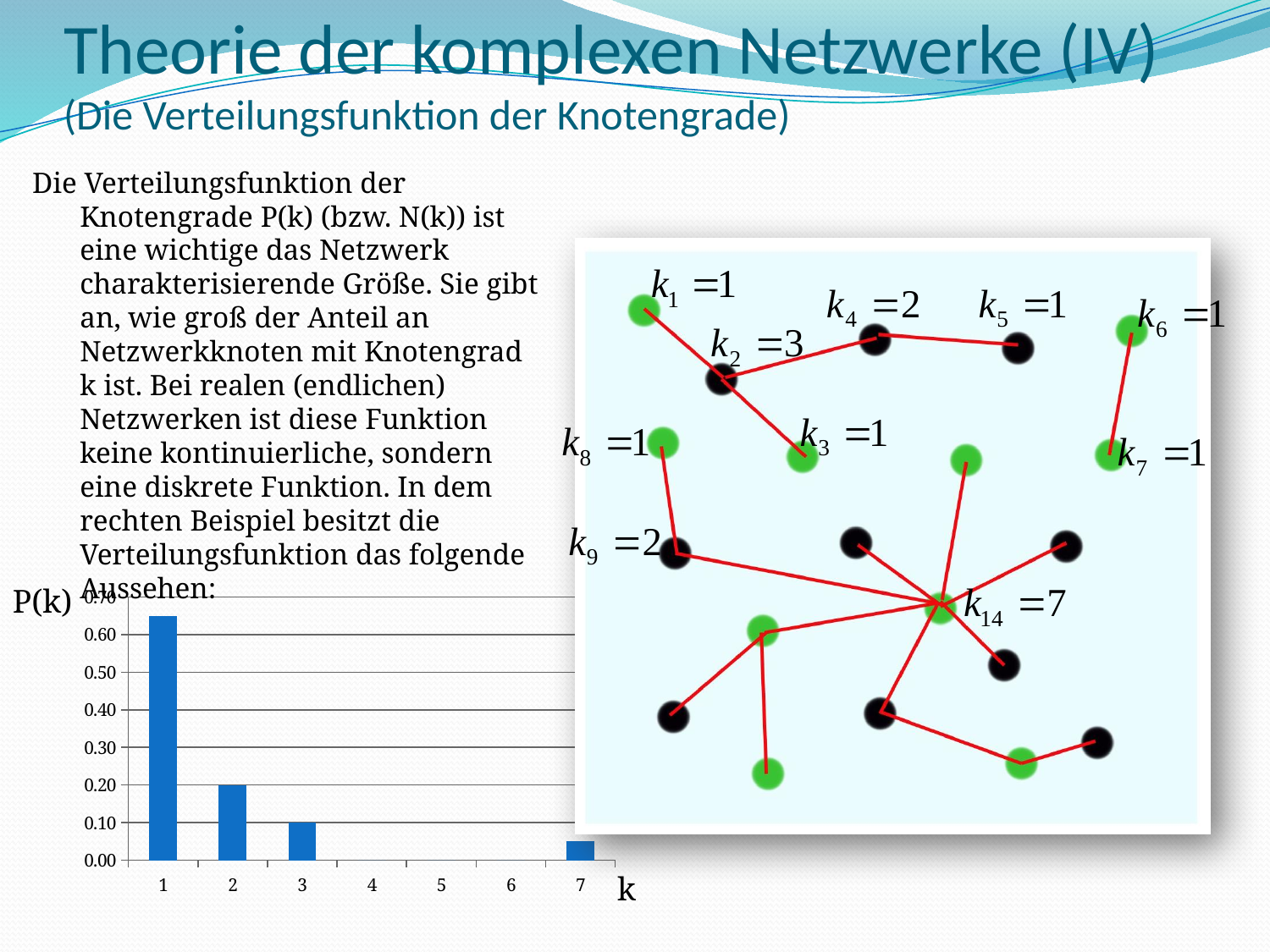
What is the value of P(k) for k = 3 in the bar chart? 0.10 What label is shown on the vertical axis of the bar chart? P(k) How many k values in the bar chart have a P(k) of zero (no visible bar)? 3 What is the value of P(k) for k = 2 in the bar chart? 0.20 How many k categories are shown on the x axis of the bar chart? 7 Which has a larger P(k) in the bar chart, k = 2 or k = 3? k = 2 Is the value of P(k) for k = 1 greater or less than 0.60? greater Is the value of P(k) for k = 7 greater or less than 0.10? less What kind of chart is shown at the bottom left of the slide? bar chart Do the P(k) values generally rise or fall as k increases from 1 to 3? fall What is the difference between P(k) for k = 2 and P(k) for k = 3? 0.10 Which value of k has the highest P(k) in the bar chart? 1